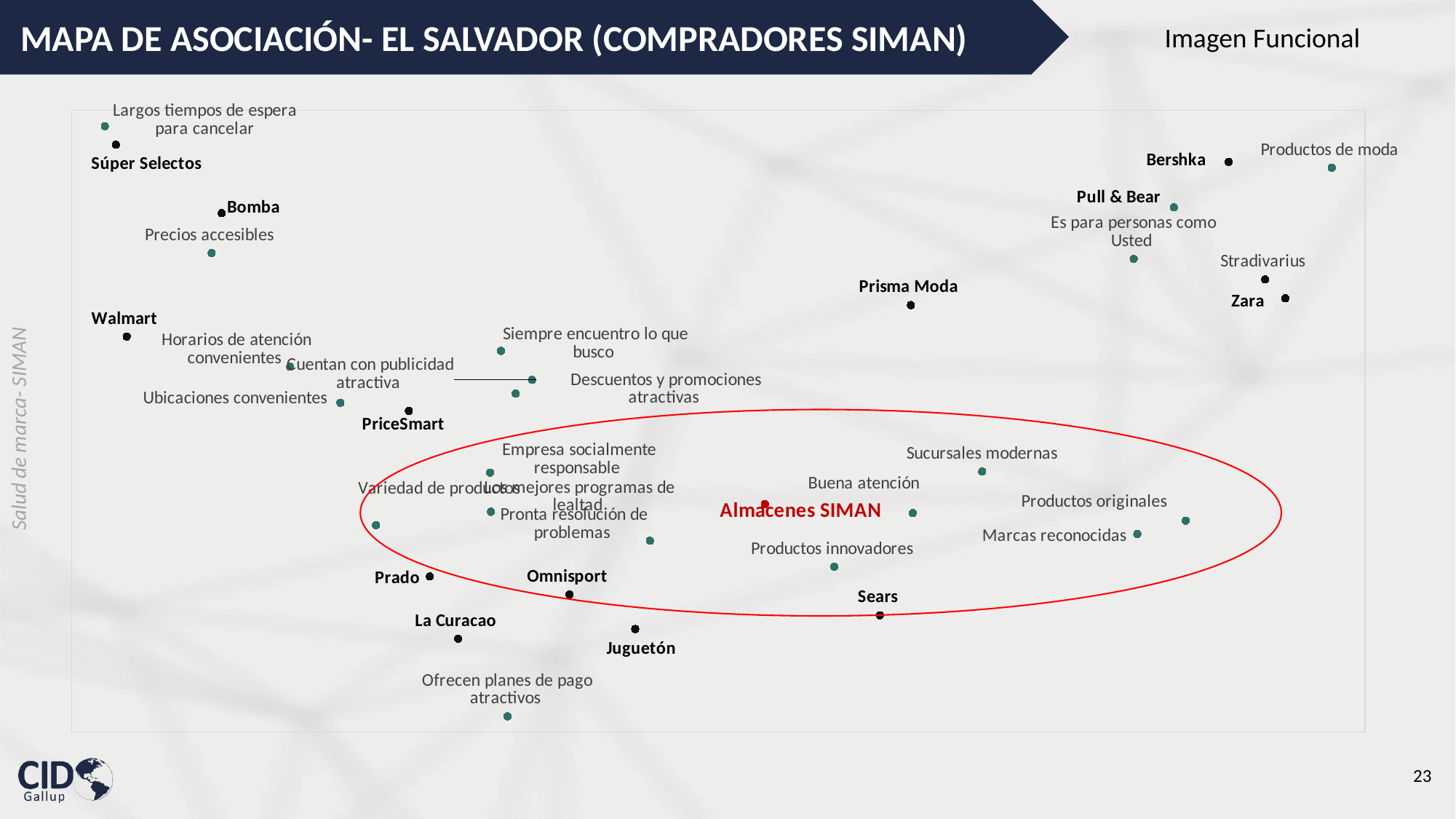
Which brand's point lies closest to the attribute 'Ofrecen planes de pago atractivos'? La Curacao Which brand is plotted lowest (nearest the bottom) on the map? La Curacao How many brands (black and red labelled points) are plotted on the map? 15 Which brand's point lies closest to the attribute 'Productos de moda'? Bershka Which brand is highlighted in red on the association map? Almacenes SIMAN Which brand's point lies closest to the attribute 'Largos tiempos de espera para cancelar'? Súper Selectos Which brand's point lies closest to the attribute 'Precios accesibles'? Bomba How many attribute points (green dots) are plotted on the map? 19 Which brand is plotted furthest to the right on the map? Zara Which brand's point lies closest to Stradivarius on the map? Zara Which brand is plotted highest (nearest the top) on the map? Súper Selectos What kind of chart is shown on the slide? Scatter plot (association map)